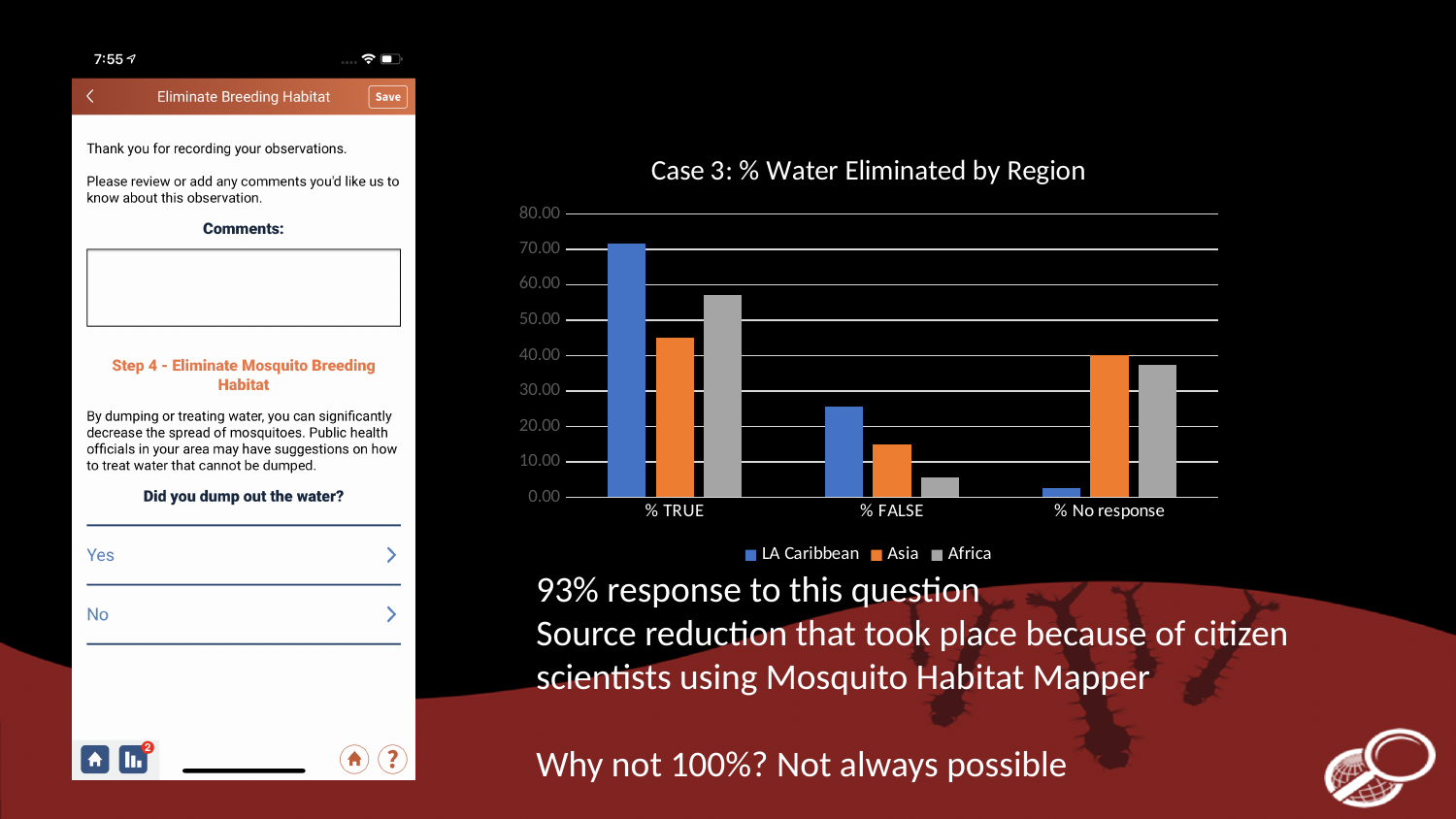
Which region has the highest value for % TRUE? LA Caribbean What kind of chart is shown on the slide? bar chart How many categories are shown along the x axis of the chart? 3 How many series does the chart's legend list? 3 Is the value for Africa in % FALSE greater or less than 10.00? less Which region has the lowest value for % No response? LA Caribbean Which is larger: the Asia value for % TRUE or the Asia value for % FALSE? % TRUE What is the title of the chart? Case 3: % Water Eliminated by Region Is the value for Asia in % No response greater or less than 30.00? greater Which region has the lowest value for % FALSE? Africa Which series does the legend show in orange? Asia Is the value for LA Caribbean in % TRUE greater or less than 70.00? greater